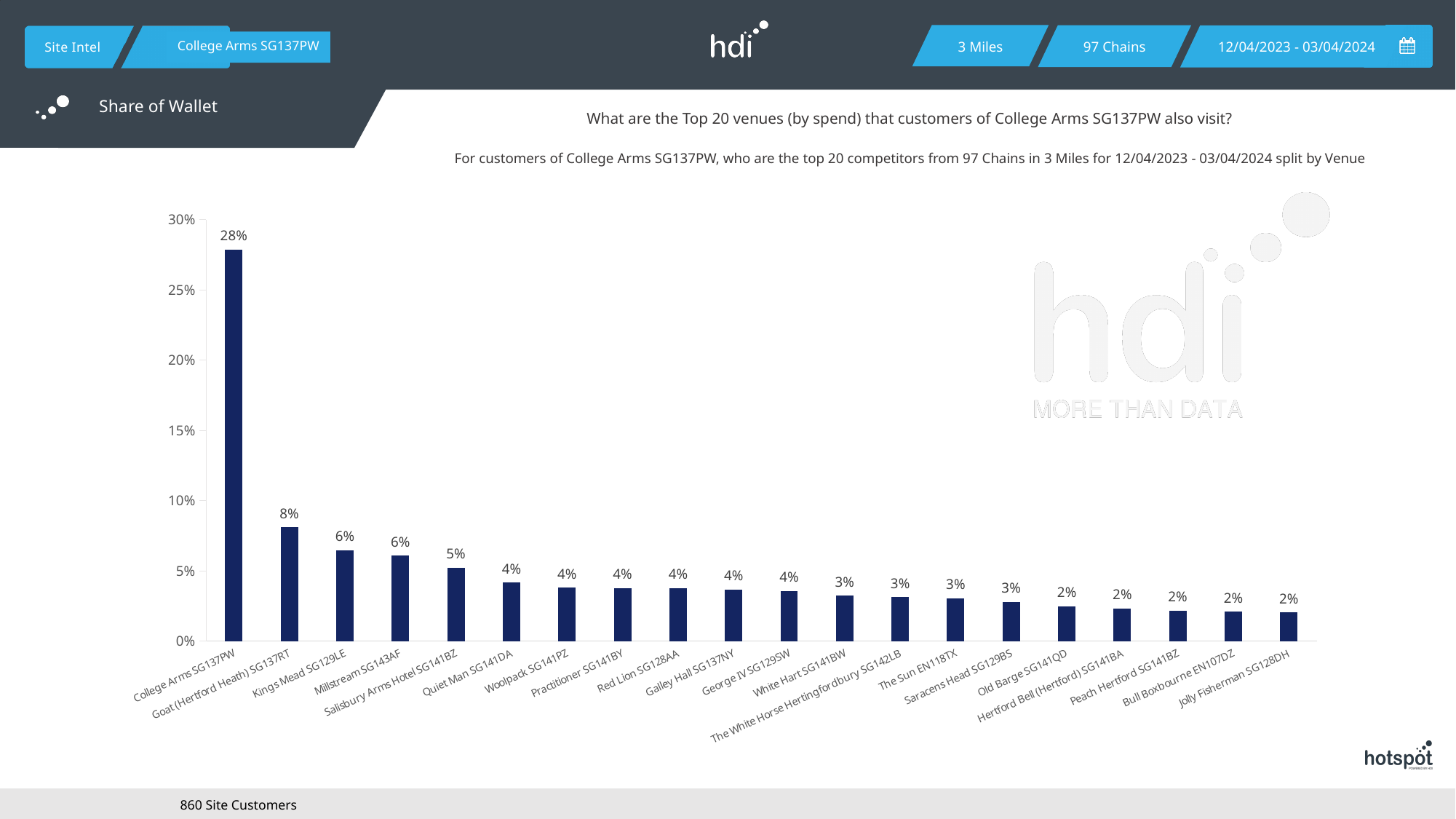
Which is larger, the value for Goat (Hertford Heath) SG137RT or the value for Kings Mead SG129LE? Goat (Hertford Heath) SG137RT What is the value for College Arms SG137PW? 28% What is the difference between the values for College Arms SG137PW and Goat (Hertford Heath) SG137RT? 20% What is the value for Goat (Hertford Heath) SG137RT? 8% What is the value for Jolly Fisherman SG128DH? 2% How many venues are shown on the chart? 20 Do the values rise or fall from left to right along the x axis? fall What is the value for Salisbury Arms Hotel SG141BZ? 5% Which venue has the highest value? College Arms SG137PW What is the value for White Hart SG141BW? 3% What kind of chart is shown on the slide? bar chart Is the value for College Arms SG137PW greater or less than 25%? greater